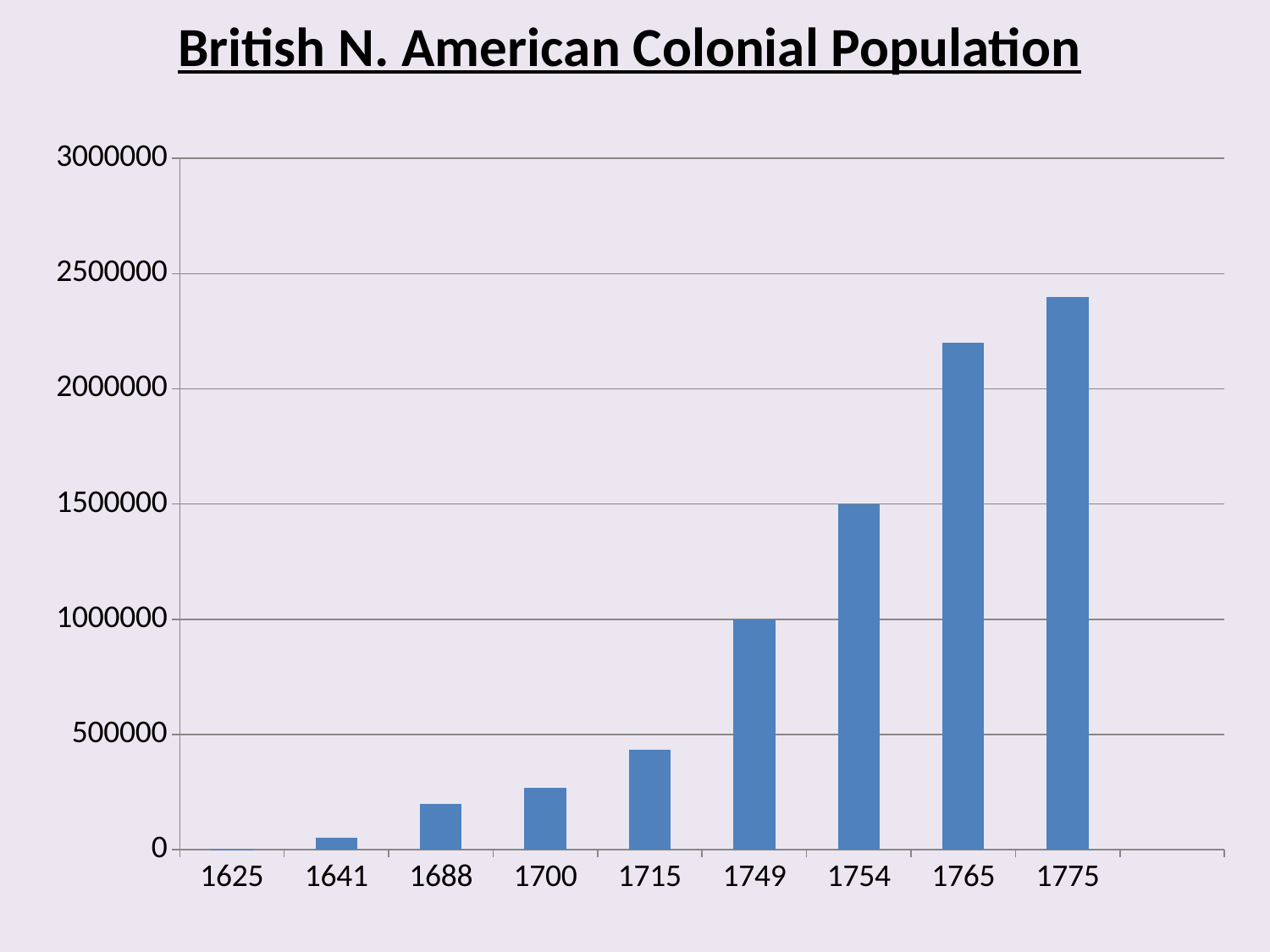
Do the population values rise or fall from 1625 to 1775? rise What kind of chart is shown on the slide? bar chart Is the value for 1765 greater or less than 2500000? less What is the population value for 1749? 1000000 Is the value for 1775 greater or less than 2000000? greater What is the population value for 1754? 1500000 Which year has the larger population, 1700 or 1754? 1754 How many years are shown on the x axis of the chart? 9 What is the title of the chart? British N. American Colonial Population Is the value for 1715 greater or less than 500000? less Which year has the highest population in the chart? 1775 Which year has the lowest population in the chart? 1625